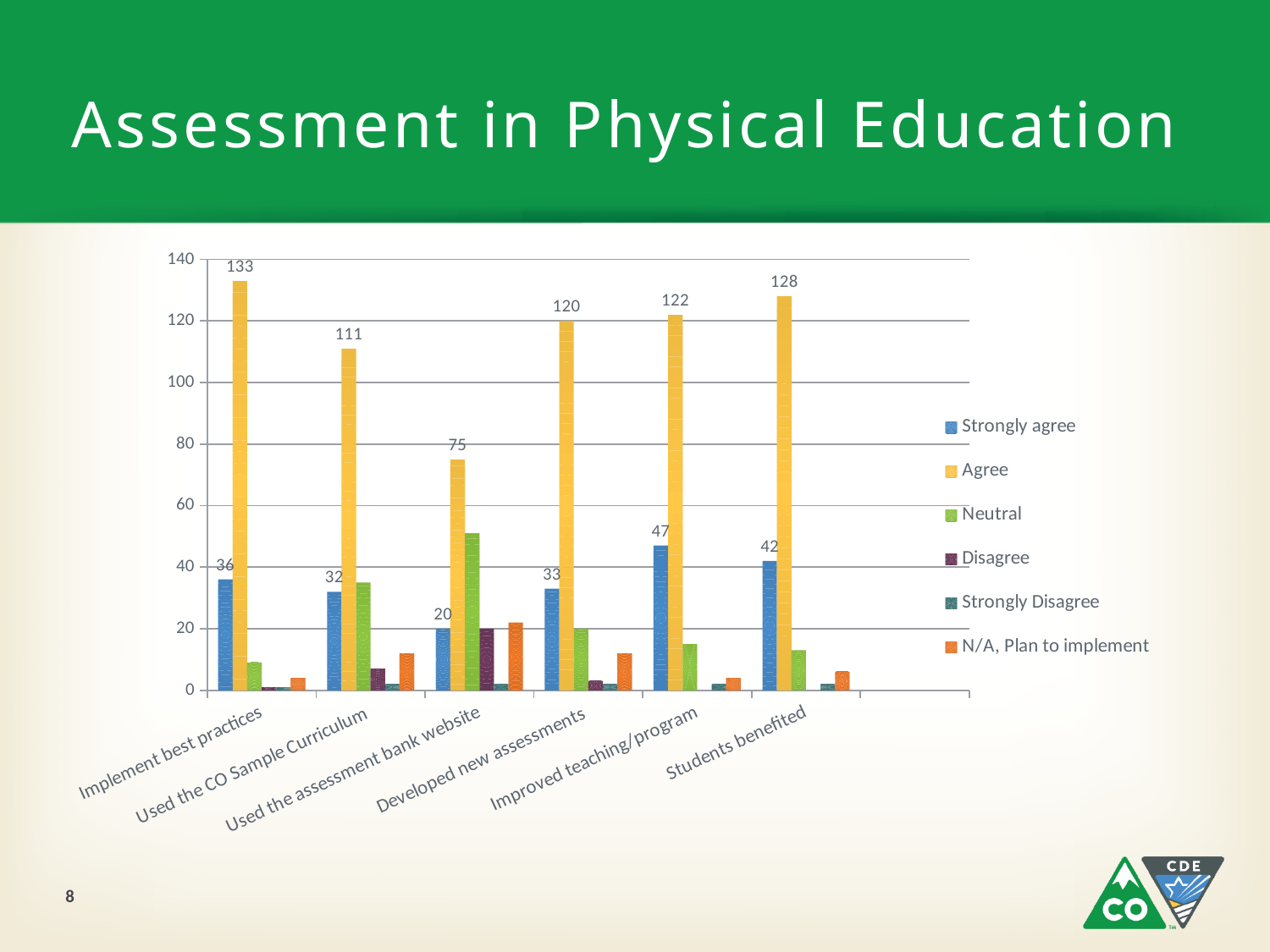
Which is larger, the Strongly agree value for Developed new assessments or for Students benefited? Students benefited How many categories are shown on the x axis? 6 What kind of chart is shown on the slide? bar chart What colour are the Agree bars? yellow What is the Agree value for Implement best practices? 133 Which category has the lowest Strongly agree value? Used the assessment bank website What is the difference between the Agree values for Students benefited and Used the CO Sample Curriculum? 17 How many series does the legend list? 6 What is the Agree value for Used the assessment bank website? 75 What is the Strongly agree value for Improved teaching/program? 47 Which category has the highest Agree value? Implement best practices Is the Neutral value for Used the assessment bank website greater or less than 40? greater